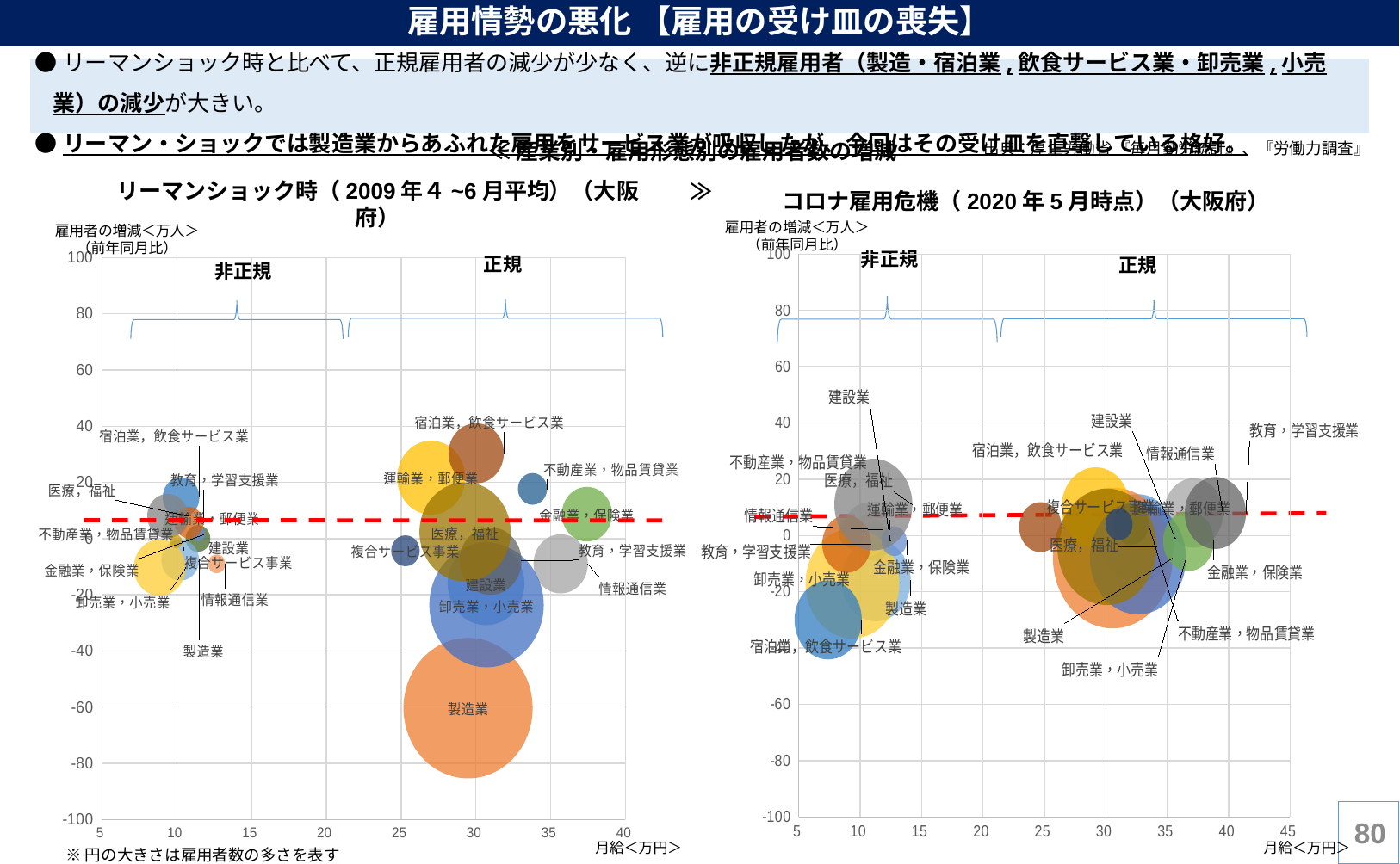
In the left chart (リーマンショック時), is the value for 宿泊業，飲食サービス業 in the 正規 group greater or less than 20? greater In the left chart (リーマンショック時), which is higher on the y axis: 製造業 (正規) or 宿泊業，飲食サービス業 (正規)? 宿泊業，飲食サービス業 (正規) What kind of chart is the left chart (リーマンショック時)? Bubble chart In the left chart (リーマンショック時), is the value for 卸売業，小売業 in the 正規 group greater or less than 0? less What is the maximum value shown on the y axis of the left chart? 100 What does the x axis represent in both charts? 月給<万円> In the left chart (リーマンショック時), is the value for 製造業 in the 正規 group greater or less than -40? less How many charts are shown on the slide? 2 What is the title of the right chart? コロナ雇用危機（2020年5月時点）（大阪府） In the left chart (リーマンショック時), which bubble is the lowest on the y axis? 製造業 (正規)